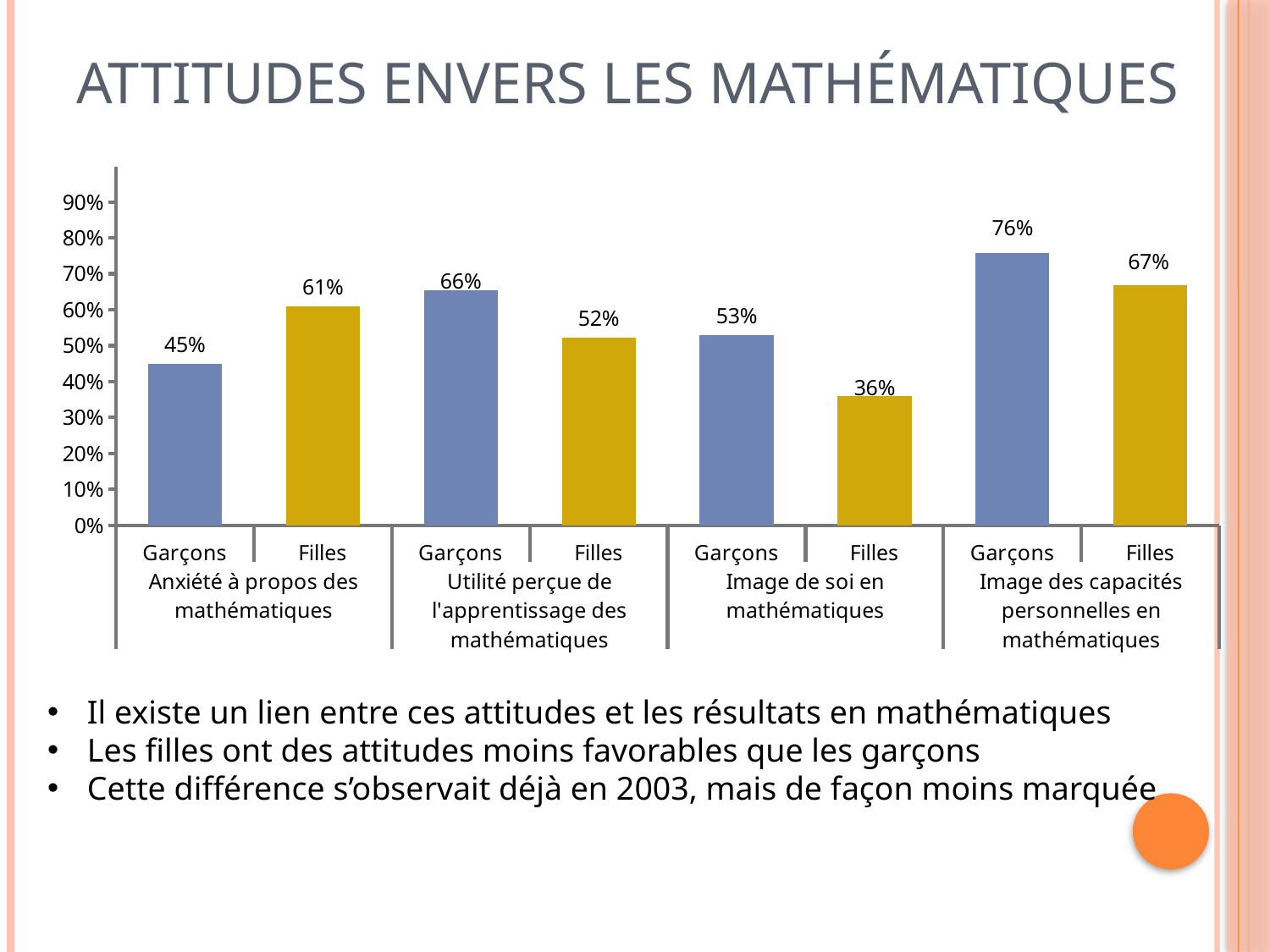
Which bar has the lowest value in the chart? Filles, Image de soi en mathématiques (36%) What is the difference between Filles and Garçons under 'Anxiété à propos des mathématiques'? 16% What is the difference between Garçons and Filles under 'Utilité perçue de l'apprentissage des mathématiques'? 14% What is the value for Filles under 'Image des capacités personnelles en mathématiques'? 67% How many bars are plotted in the chart? 8 Which bar has the highest value in the chart? Garçons, Image des capacités personnelles en mathématiques (76%) What is the value for Garçons under 'Anxiété à propos des mathématiques'? 45% Is the value for Garçons under 'Image des capacités personnelles en mathématiques' greater or less than 70%? greater What is the value for Filles under 'Image de soi en mathématiques'? 36% What colour are the Filles bars? Yellow (gold) What kind of chart is shown on the slide? Bar chart Under 'Image de soi en mathématiques', which is larger, Garçons or Filles? Garçons